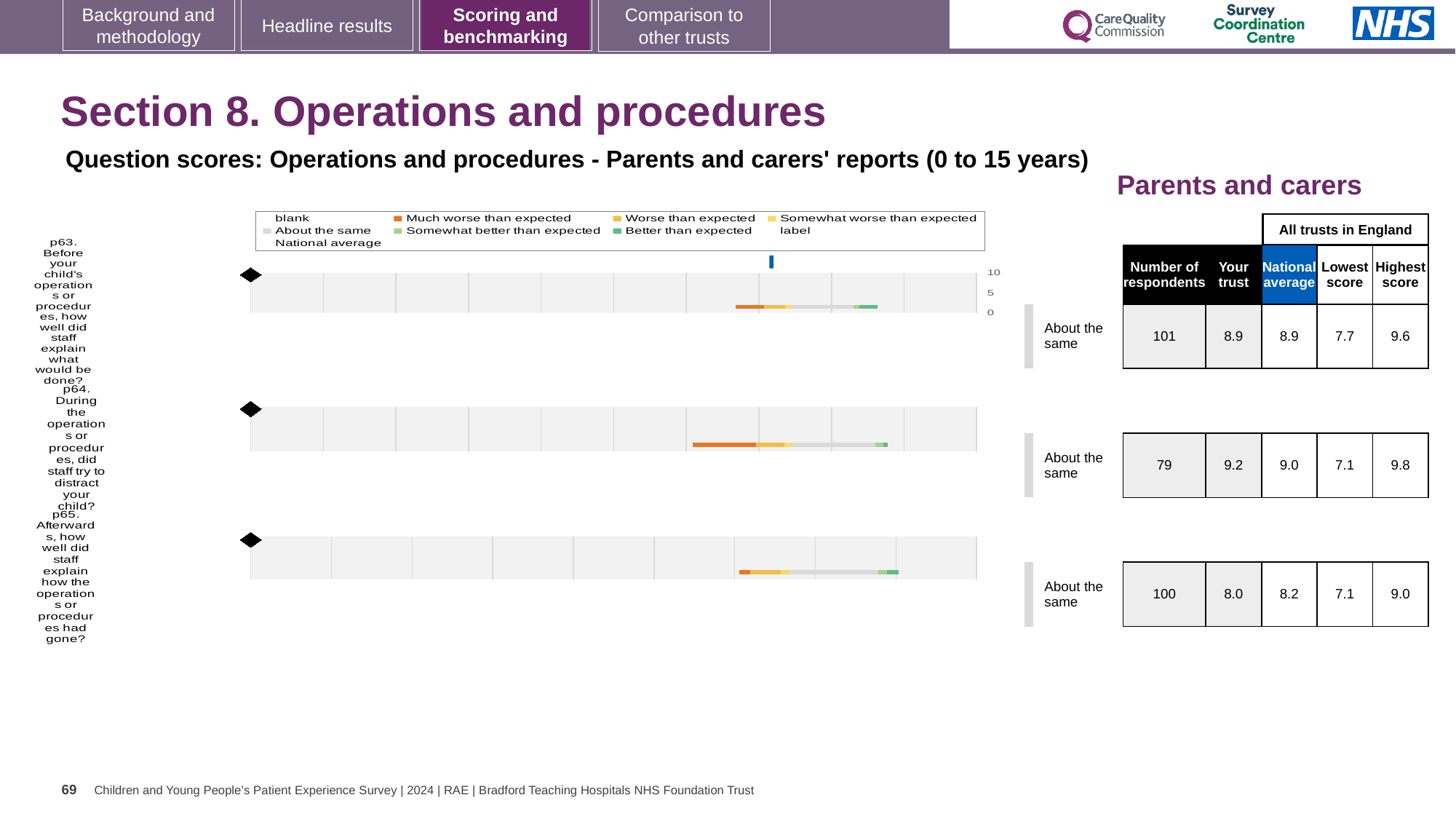
Which of the three questions (p63, p64, p65) has the lowest 'Your trust' score? p65 For question p65, what is the difference between the national average score and the 'Your trust' score? 0.2 What is the 'Your trust' score for question p63 (Before your child's operations or procedures, how well did staff explain what would be done?)? 8.9 How many respondents answered question p63? 101 What is the lowest score among all trusts in England for question p64? 7.1 How many question charts are shown on the slide? 3 What is the highest score among all trusts in England for question p65 (Afterwards, how well did staff explain how the operations or procedures had gone?)? 9.0 For question p64, which is larger: the 'Your trust' score or the national average score? Your trust Which of the three questions (p63, p64, p65) has the highest 'Your trust' score? p64 What is the national average score for question p64 (During the operations or procedures, did staff try to distract your child?)? 9.0 What benchmark category is shown next to the chart for question p63? About the same What kind of chart is used to show the question scores on this slide? Bar chart